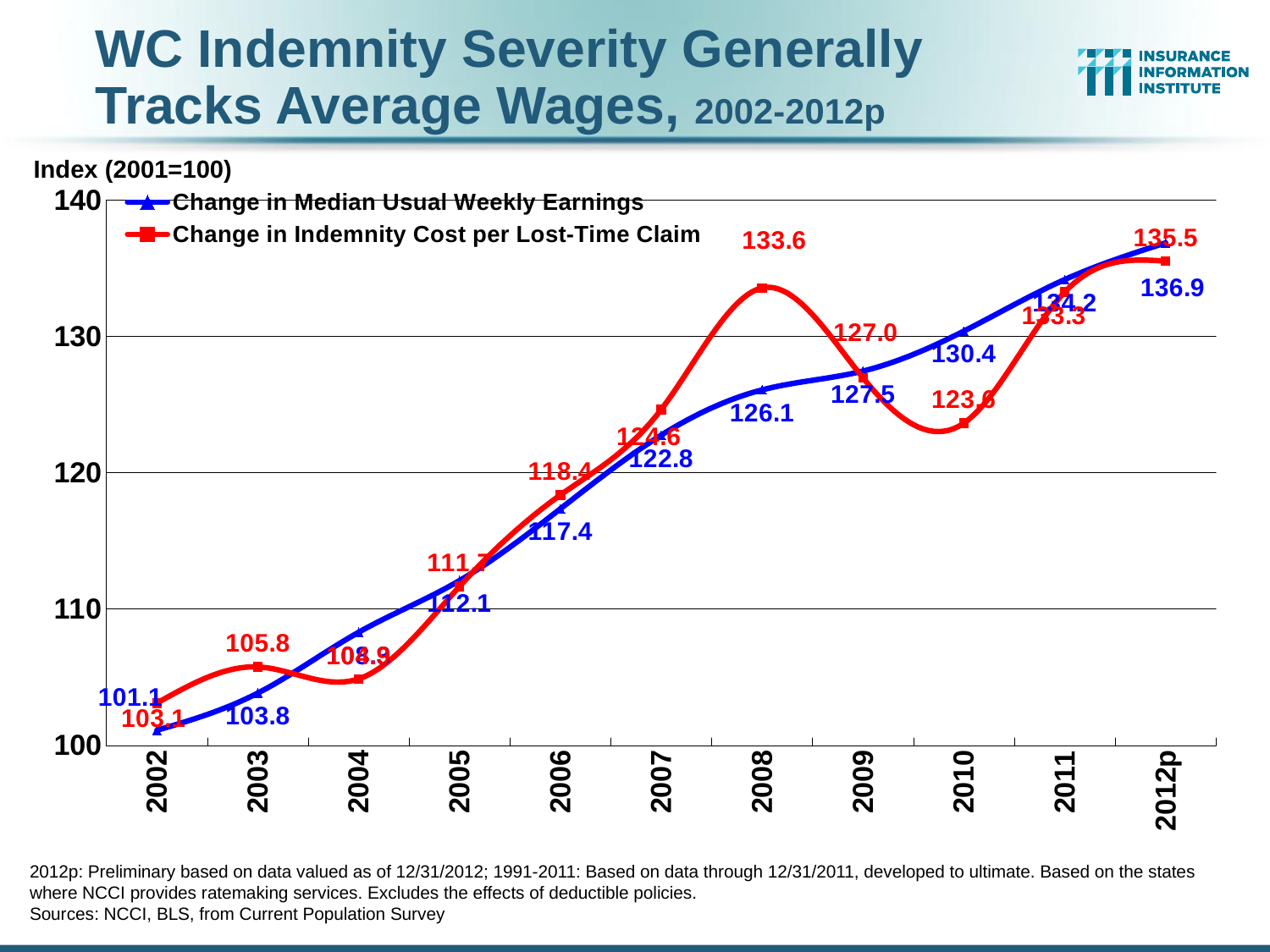
Does Change in Median Usual Weekly Earnings rise or fall from 2002 to 2012p? Rise What is the value of Change in Median Usual Weekly Earnings in 2007? 122.8 In 2008, which series has the higher value: Change in Median Usual Weekly Earnings or Change in Indemnity Cost per Lost-Time Claim? Change in Indemnity Cost per Lost-Time Claim What kind of chart is shown on the slide? Line chart What is the value of Change in Indemnity Cost per Lost-Time Claim in 2008? 133.6 What is the value of Change in Median Usual Weekly Earnings in 2010? 130.4 What is the difference between Change in Median Usual Weekly Earnings and Change in Indemnity Cost per Lost-Time Claim in 2012p? 1.4 In which year does Change in Indemnity Cost per Lost-Time Claim reach its highest value? 2012p How many series does the legend list? 2 In which year is Change in Median Usual Weekly Earnings at its lowest? 2002 How many years are shown on the x axis? 11 Is the value for Change in Median Usual Weekly Earnings in 2004 greater or less than 110? less